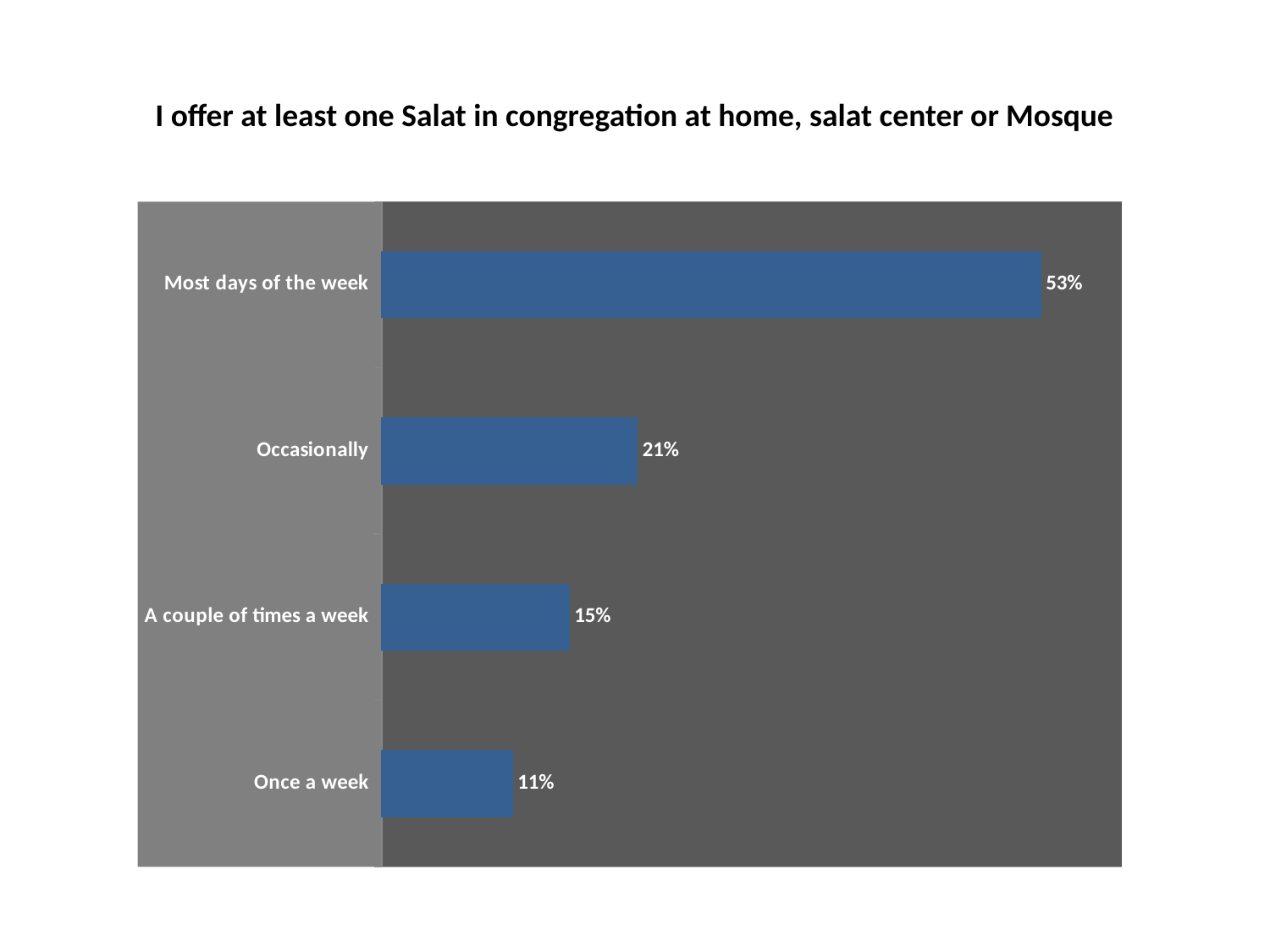
What kind of chart is shown on the slide? Bar chart Which is larger, the value for "Occasionally" or the value for "A couple of times a week"? Occasionally What percentage is shown for "Most days of the week"? 53% What percentage is shown for "Once a week"? 11% Which category has the lowest value? Once a week What is the difference between the values for "A couple of times a week" and "Once a week"? 4% What percentage is shown for "Occasionally"? 21% What is the title of the chart? I offer at least one Salat in congregation at home, salat center or Mosque What is the difference between the values for "Most days of the week" and "Occasionally"? 32% How many categories are shown in the chart? 4 Which category has the highest value? Most days of the week What percentage is shown for "A couple of times a week"? 15%